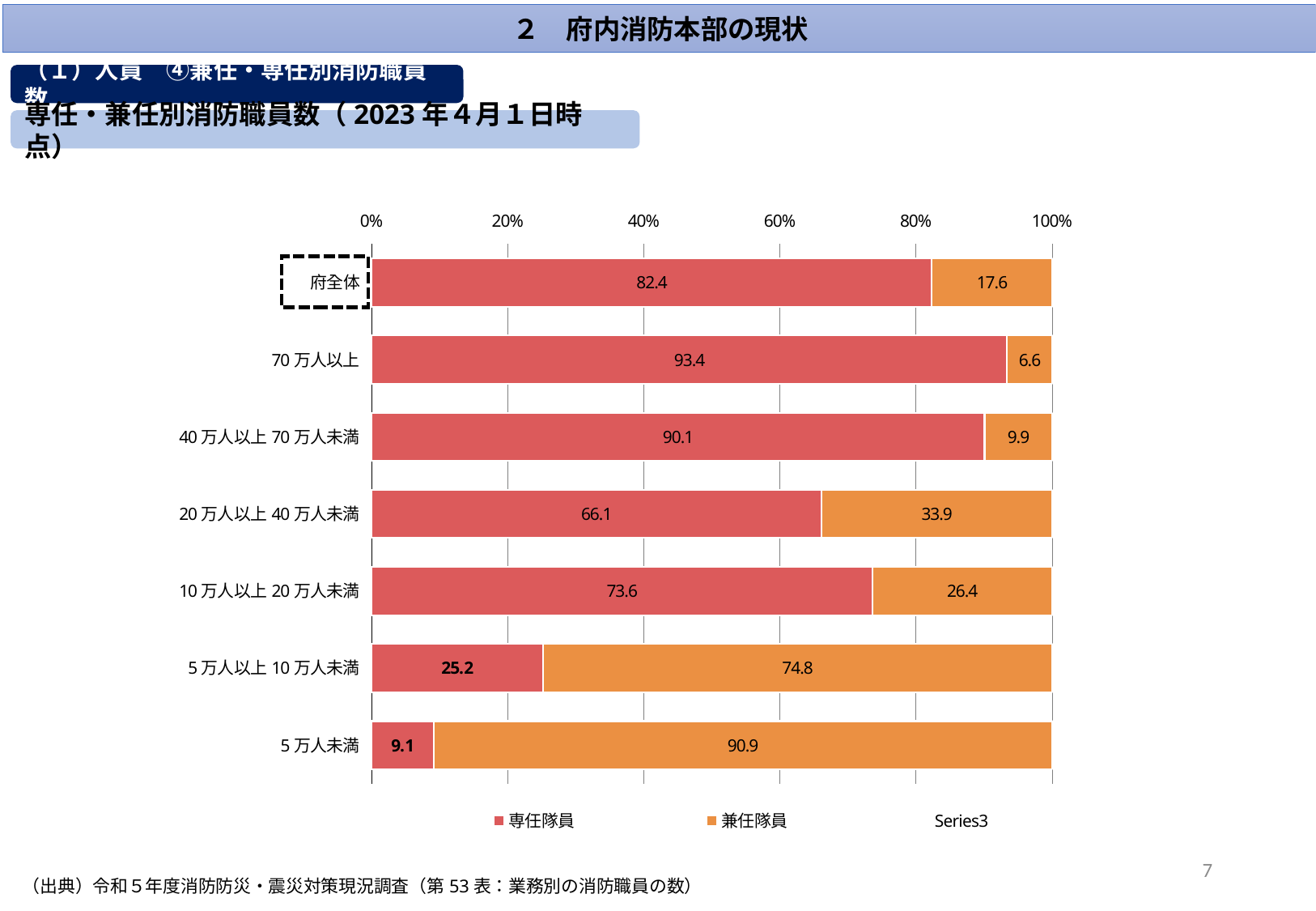
How many categories are shown on the chart? 7 Which is larger: the 兼任隊員 value for 10万人以上20万人未満 or for 20万人以上40万人未満? 20万人以上40万人未満 What is the value for 兼任隊員 in the 5万人未満 category? 90.9 Which category has the lowest value for 専任隊員? 5万人未満 What is the difference between the 専任隊員 values for 70万人以上 and 5万人以上10万人未満? 68.2 How many series does the legend list? 3 What colour represents 兼任隊員 in the chart? Orange What is the value for 兼任隊員 in the 20万人以上40万人未満 category? 33.9 What kind of chart is shown on the slide? Stacked bar chart Which category has the highest value for 兼任隊員? 5万人未満 What is the value for 専任隊員 in the 府全体 category? 82.4 Which category has the highest value for 専任隊員? 70万人以上